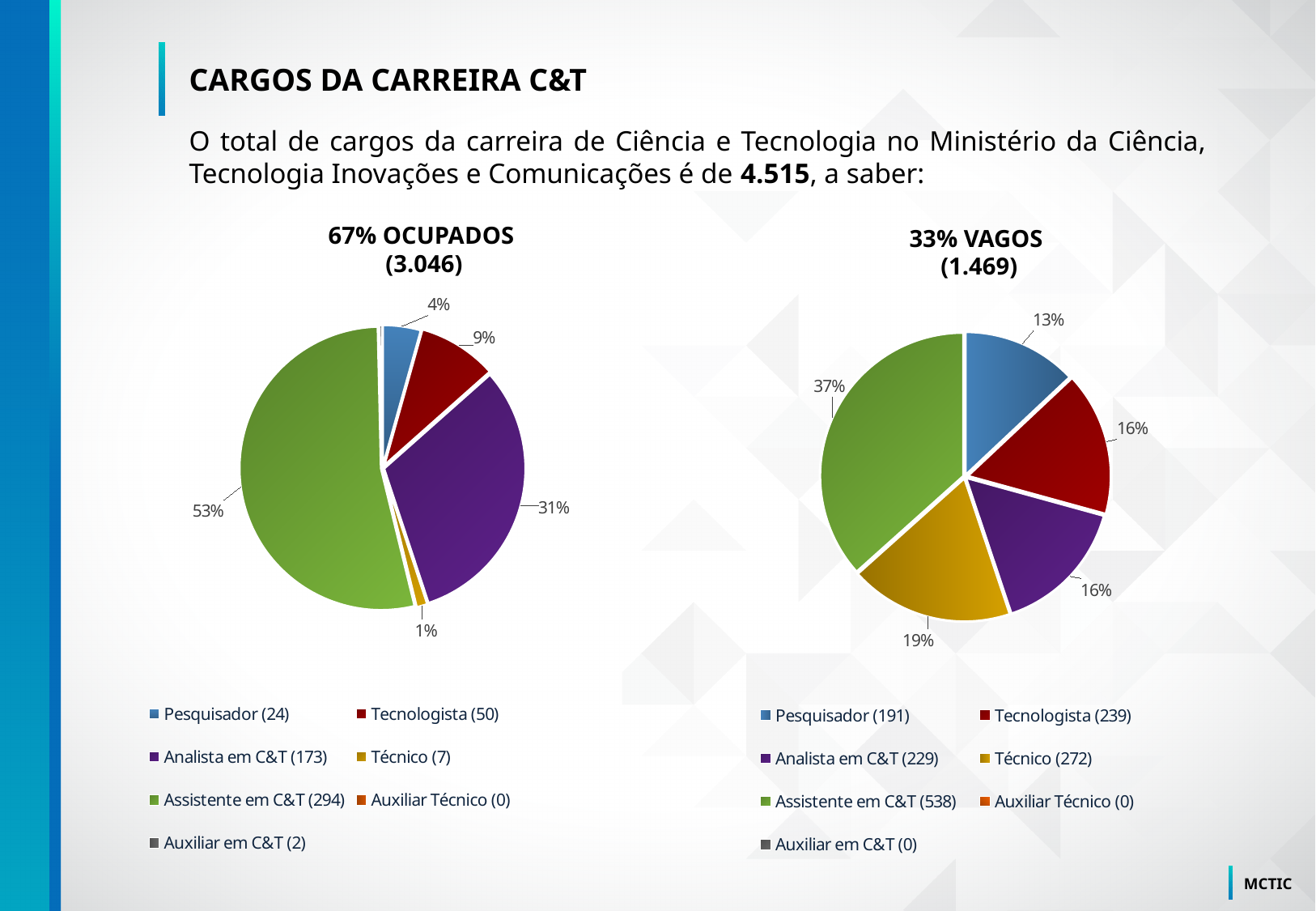
In the "33% VAGOS (1.469)" pie chart, what is the difference in percentage points between the Assistente em C&T slice and the Técnico slice? 18 percentage points In the "33% VAGOS (1.469)" pie chart, what share does Técnico have? 19% What number is shown in parentheses next to Assistente em C&T in the legend of the "33% VAGOS (1.469)" pie chart? 538 In the "67% OCUPADOS (3.046)" pie chart, which category has the largest slice? Assistente em C&T In the "33% VAGOS (1.469)" pie chart, what share does Pesquisador have? 13% In the "33% VAGOS (1.469)" pie chart, what share does Assistente em C&T have? 37% In the "67% OCUPADOS (3.046)" pie chart, which is larger: the Tecnologista slice or the Pesquisador slice? Tecnologista What kind of chart is used on the left side of the slide, titled "67% OCUPADOS (3.046)"? Pie chart In the "33% VAGOS (1.469)" pie chart, which category has the largest slice? Assistente em C&T How many categories does the legend of the "67% OCUPADOS (3.046)" pie chart list? 7